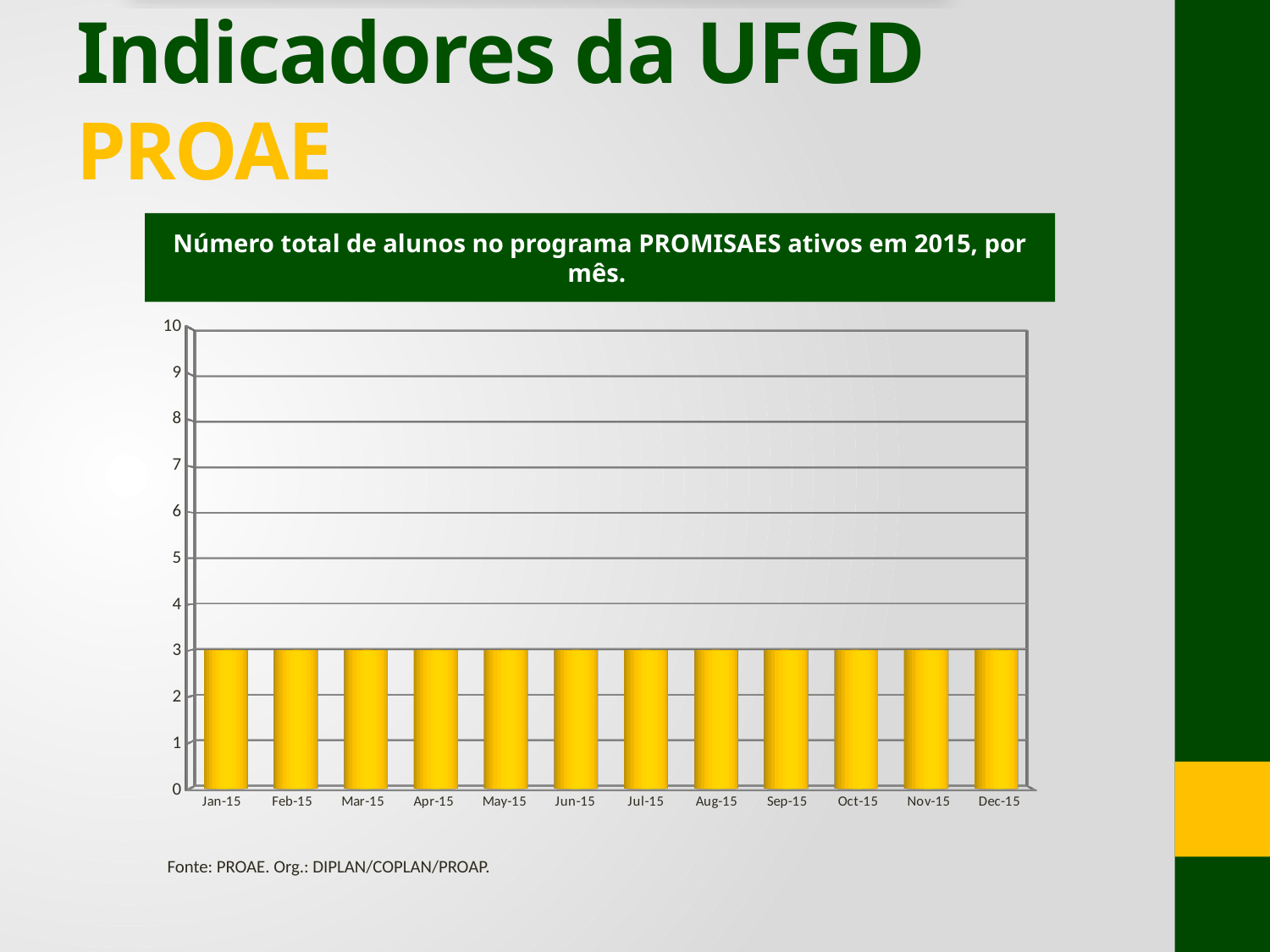
What is the value for Jul-15? 3 Is the value for Oct-15 greater or less than 2? greater What is the value for Jan-15? 3 How many months are shown on the x axis of the chart? 12 What is the difference between the values for Mar-15 and Sep-15? 0 What is the highest value shown on the vertical axis? 10 What kind of chart is shown on the slide? bar chart Do the values rise, fall or stay flat from Jan-15 to Dec-15? stay flat What is the title of the chart? Número total de alunos no programa PROMISAES ativos em 2015, por mês. Is the value for May-15 greater or less than 5? less What is the value for Dec-15? 3